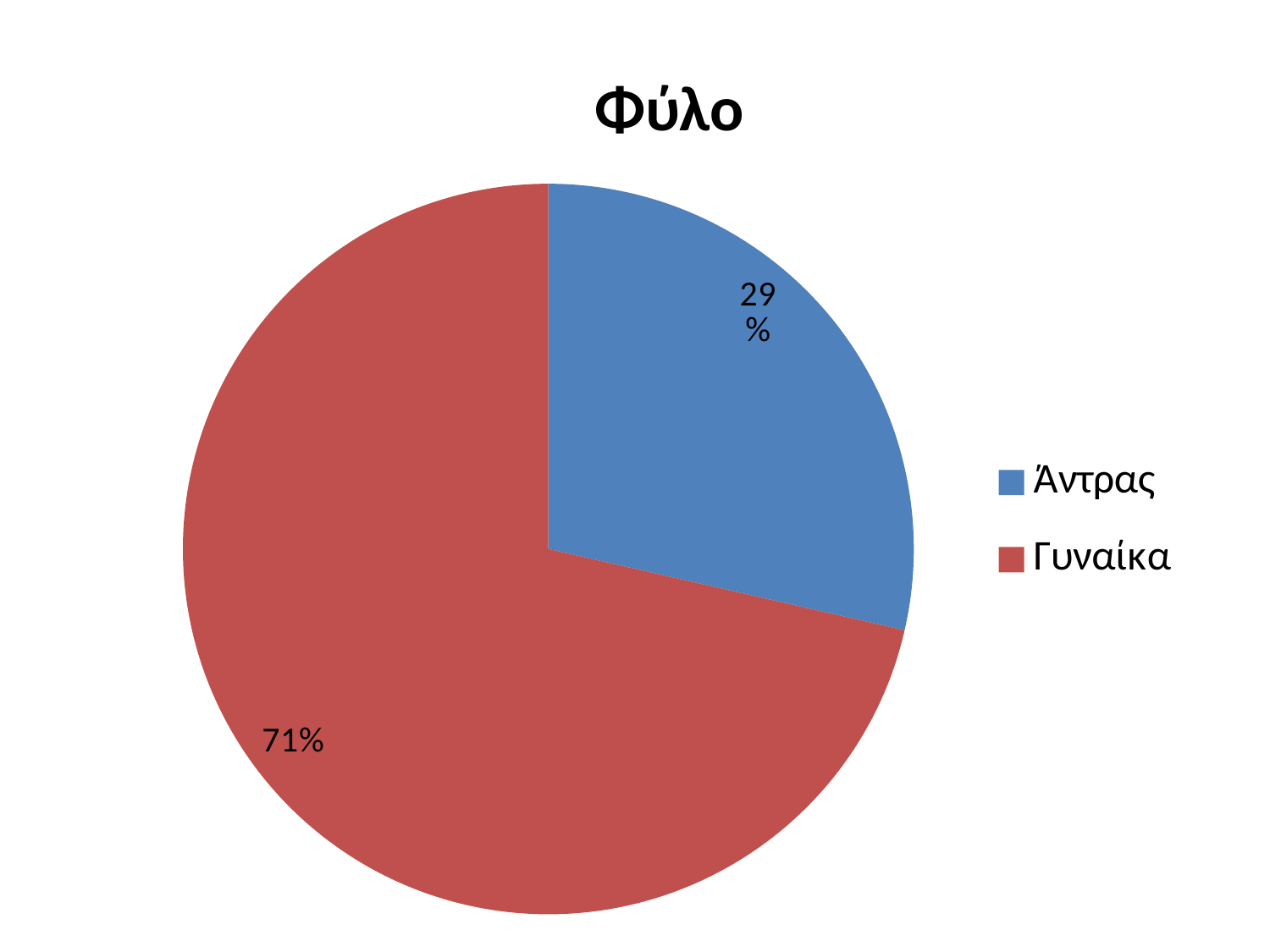
Which category has the smallest slice of the pie? Άντρας Which category has the largest slice of the pie? Γυναίκα What is the difference in percentage points between Γυναίκα and Άντρας? 42 Which is larger, the share for Άντρας or the share for Γυναίκα? Γυναίκα What share of the pie does Άντρας represent? 29% What share of the pie does Γυναίκα represent? 71% How many categories are shown in the pie chart? 2 What is the title of the chart? Φύλο What colour is the slice for Γυναίκα? Red What kind of chart is shown on the slide? Pie chart What is the total of the two percentages shown on the pie? 100%